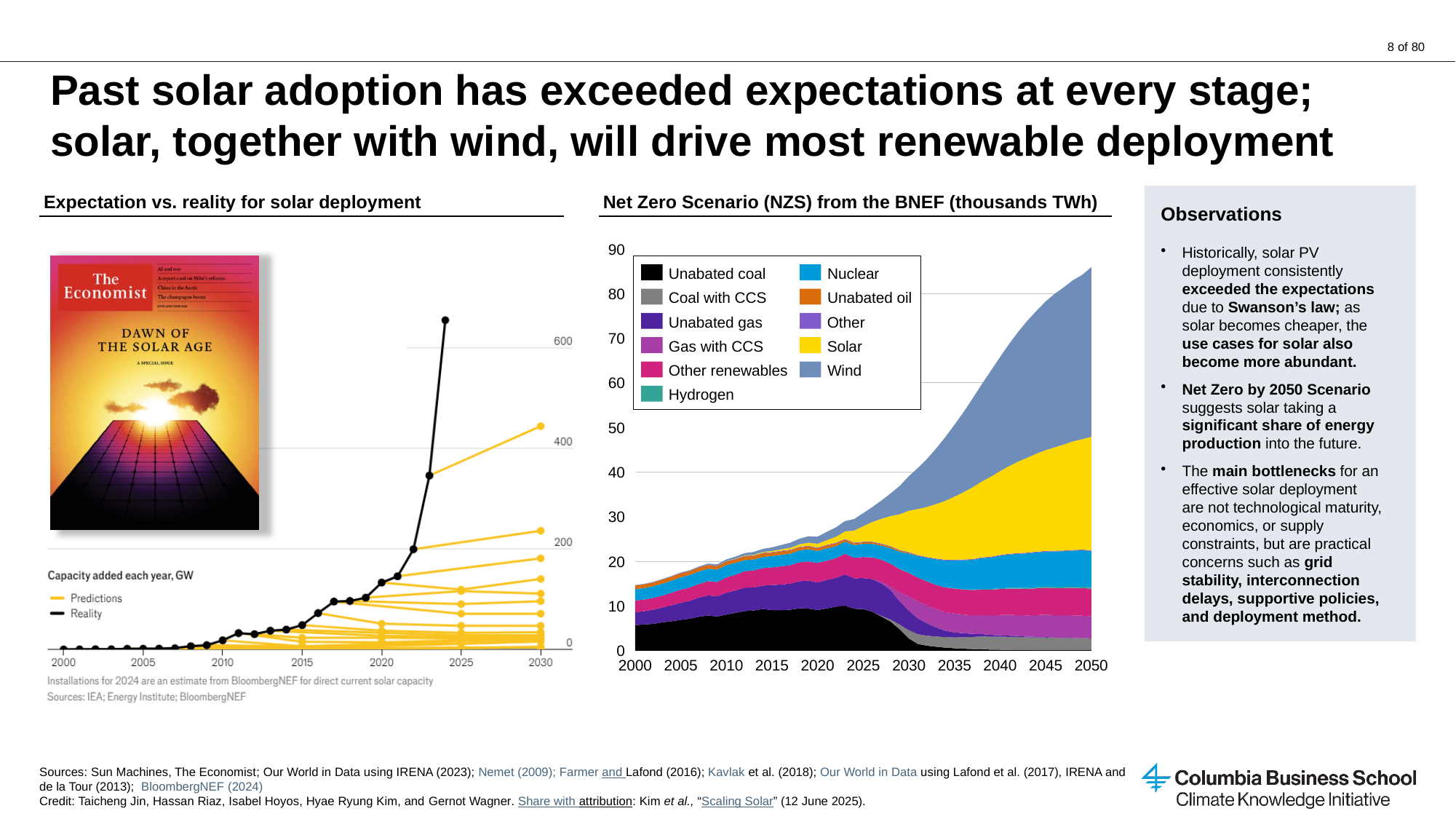
In the 'Expectation vs. reality for solar deployment' chart, does the Reality line rise or fall from 2000 to 2024? rise In the 'Net Zero Scenario (NZS) from the BNEF' chart, is the total stacked value in 2000 greater or less than 20? less How many series does the legend of the 'Expectation vs. reality for solar deployment' chart list? 2 In the 'Expectation vs. reality for solar deployment' chart, is the Reality value for 2024 greater or less than 600? greater In the 'Net Zero Scenario (NZS) from the BNEF' chart, what unit is given in the chart title for the values? thousands TWh What kind of chart is the 'Net Zero Scenario (NZS) from the BNEF' chart? stacked area chart In the 'Net Zero Scenario (NZS) from the BNEF' chart, is the total stacked value in 2050 greater or less than 80? greater How many series does the legend of the 'Net Zero Scenario (NZS) from the BNEF' chart list? 11 In the 'Net Zero Scenario (NZS) from the BNEF' chart, which series has the largest band in 2050, Wind or Solar? Wind What kind of chart is the 'Expectation vs. reality for solar deployment' chart? line chart In the 'Net Zero Scenario (NZS) from the BNEF' chart, does the total stacked value rise or fall from 2000 to 2050? rise